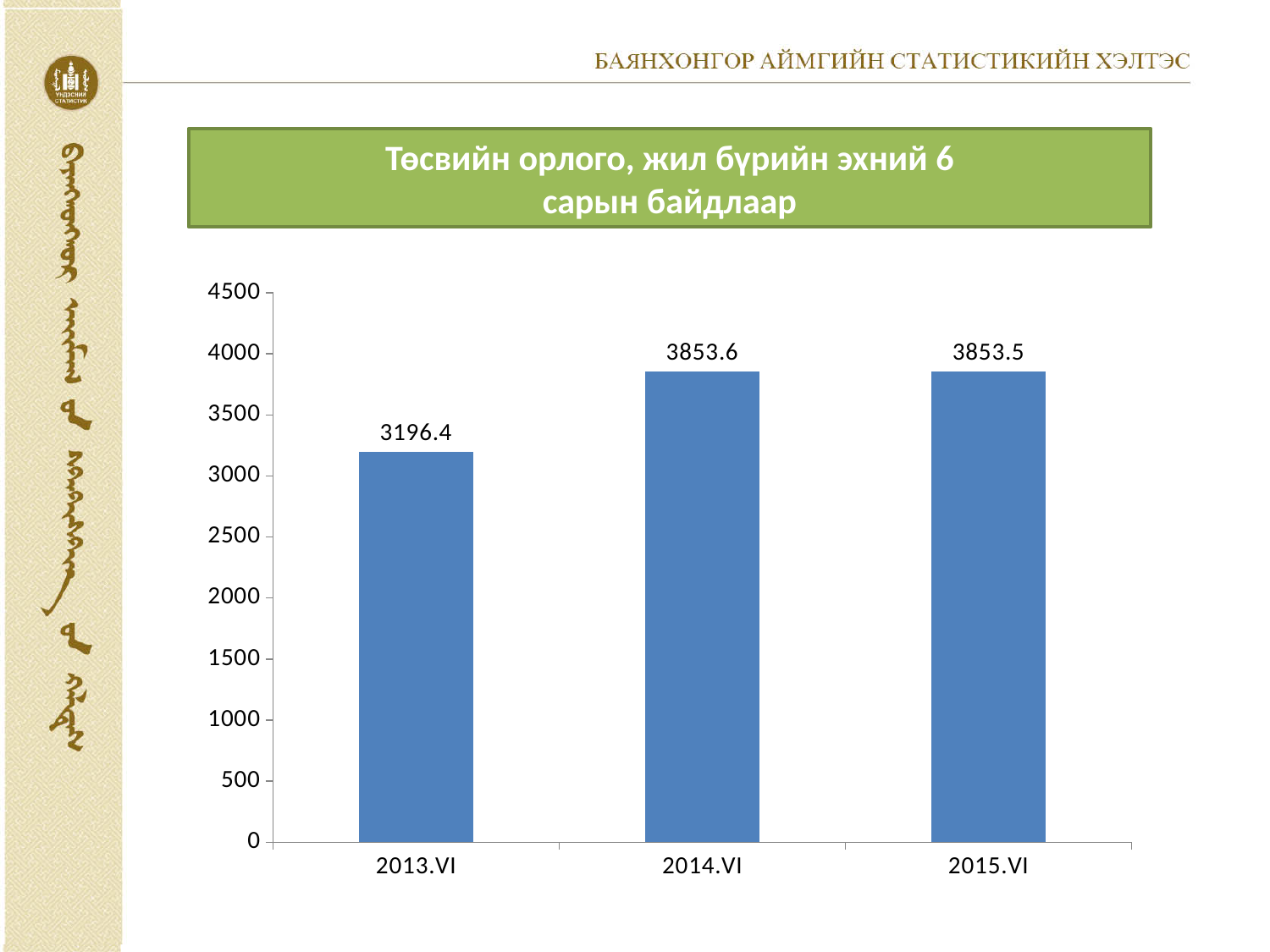
What kind of chart is shown on the slide? bar chart What is the value for 2015.VI? 3853.5 Is the value for 2013.VI greater or less than 3000? greater Does the value rise or fall from 2013.VI to 2014.VI? rise What is the difference between the values for 2014.VI and 2013.VI? 657.2 What is the difference between the values for 2015.VI and 2013.VI? 657.1 Is the value for 2014.VI greater or less than 4000? less How many categories are shown on the x axis? 3 What is the value for 2014.VI? 3853.6 What is the value for 2013.VI? 3196.4 Which is larger, the value for 2013.VI or the value for 2014.VI? 2014.VI Which category has the lowest value? 2013.VI